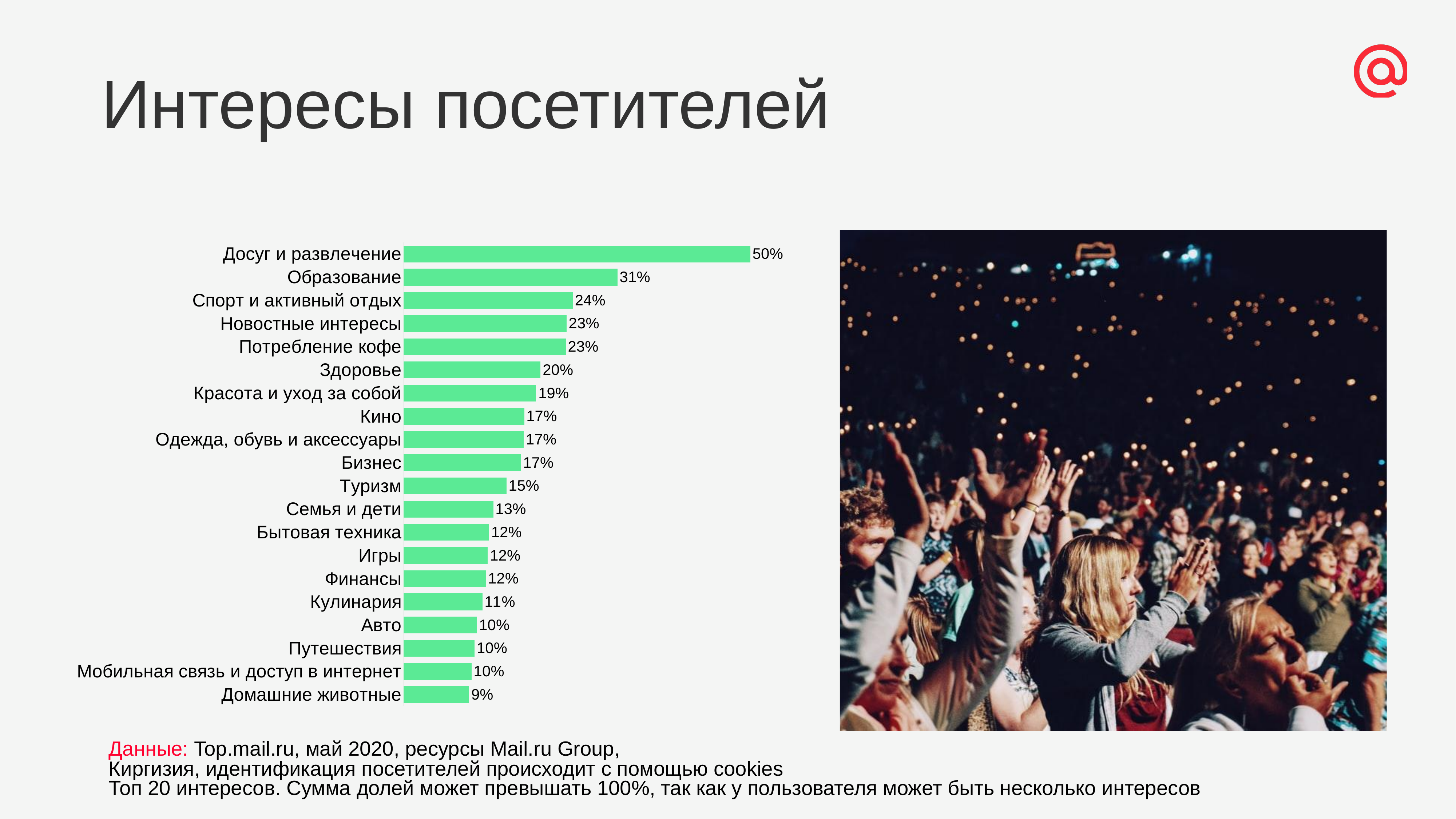
What is the difference between the values for Досуг и развлечение and Образование? 19% How many categories are shown in the chart? 20 What is the title of the slide containing the chart? Интересы посетителей What is the value for Домашние животные? 9% What kind of chart is shown on the slide? Bar chart What is the difference between the values for Спорт и активный отдых and Здоровье? 4% Which category has the highest value? Досуг и развлечение Which is larger, the value for Семья и дети or the value for Кулинария? Семья и дети What is the value for Образование? 31% What is the value for Туризм? 15% Which category has the lowest value? Домашние животные What is the value for Досуг и развлечение? 50%